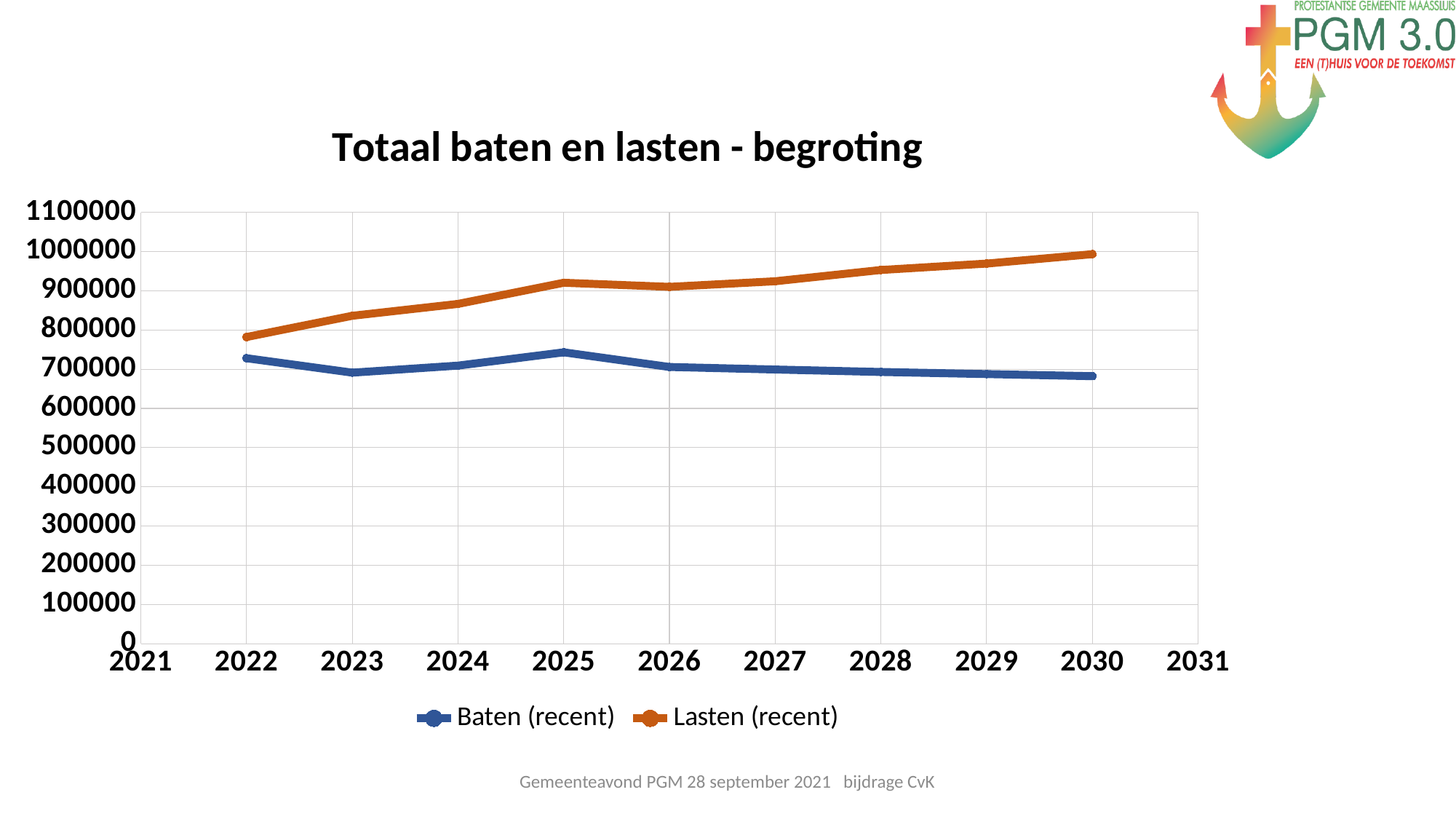
What is the title of the chart? Totaal baten en lasten - begroting In 2030, which is larger: Baten (recent) or Lasten (recent)? Lasten (recent) In which year is Baten (recent) highest? 2025 Does Lasten (recent) generally rise or fall from 2022 to 2030? rise Is the value for Baten (recent) in 2022 greater or less than 700000? greater How many years have plotted data points for each series? 9 What kind of chart is shown on the slide? line chart In which year is Lasten (recent) highest? 2030 In which year is Lasten (recent) lowest? 2022 How many series does the legend list? 2 Is the value for Lasten (recent) in 2030 greater or less than 900000? greater Is the value for Lasten (recent) in 2022 greater or less than 800000? less